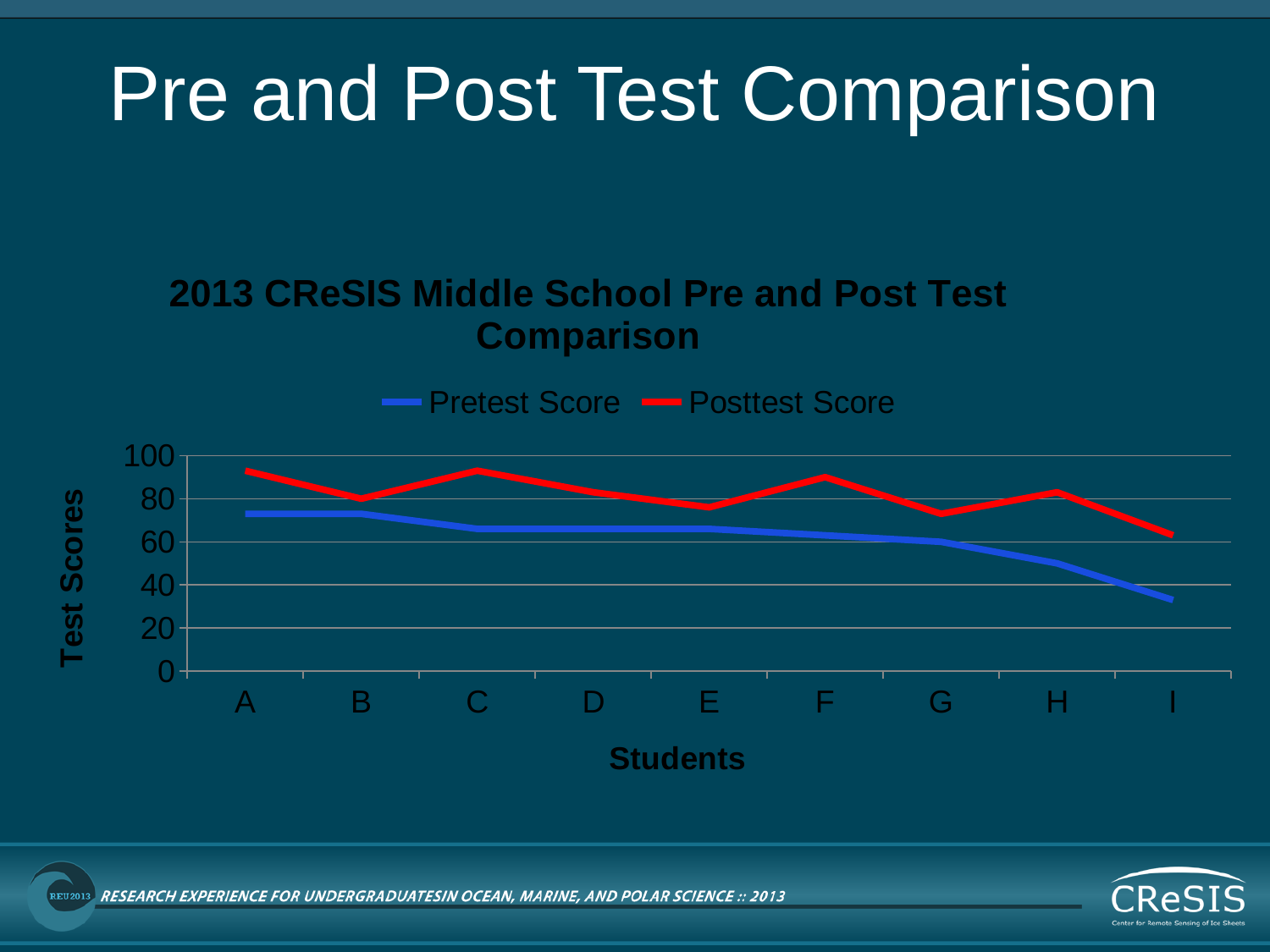
Is the Pretest Score for student A greater or less than 80? less Is the Posttest Score for student A greater or less than 80? greater Which student has the lowest Pretest Score? I Which student has the lowest Posttest Score? I Is the Pretest Score for student I greater or less than 40? less How many students are plotted along the x axis? 9 What kind of chart is shown on the slide? line chart How many series does the legend list? 2 Do the Pretest Scores generally rise or fall from student A to student I? fall For student A, which is larger, the Pretest Score or the Posttest Score? Posttest Score Which is larger, the Posttest Score for student F or for student G? student F